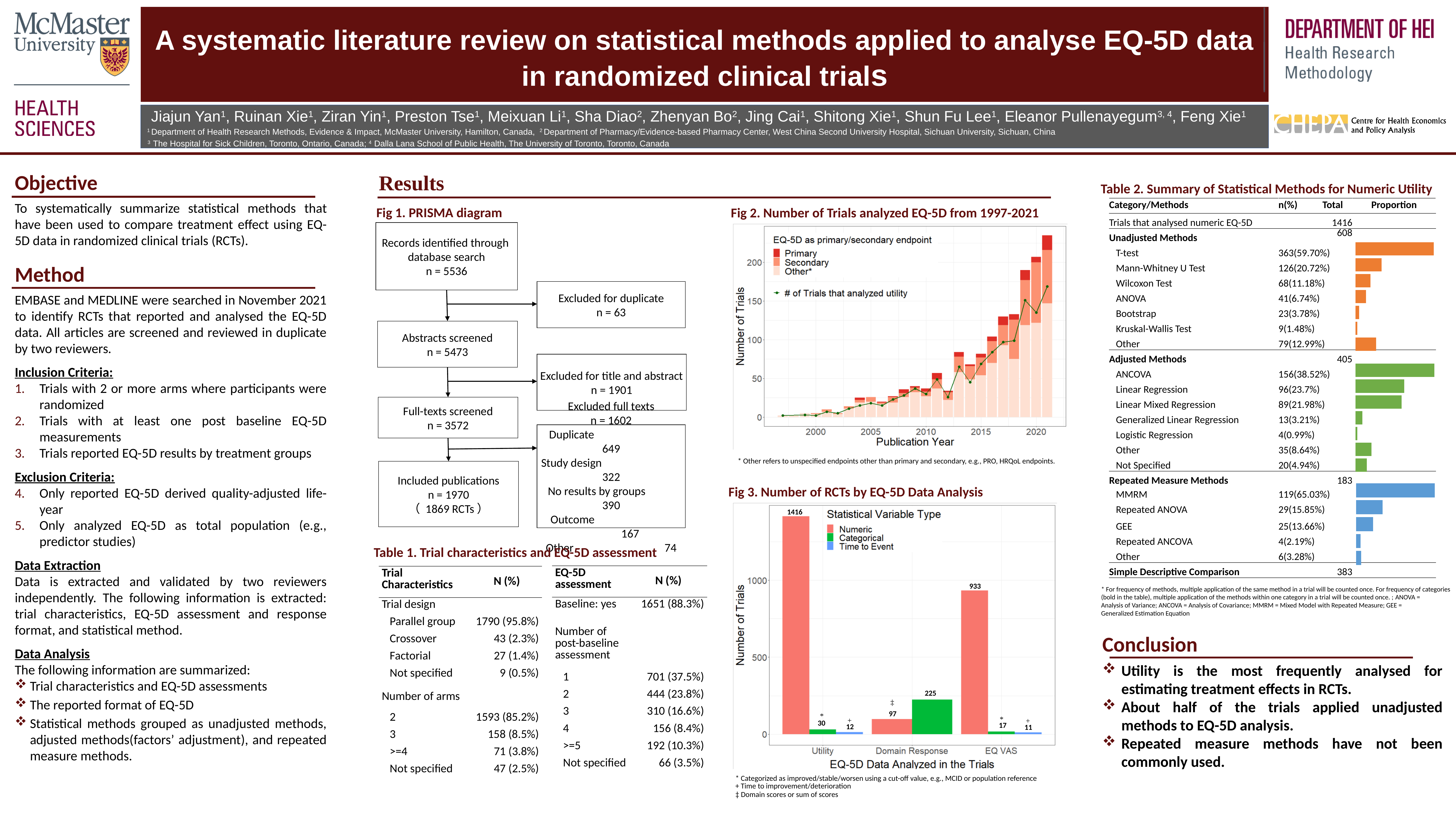
In Fig 3, what is the number of trials for Categorical analysis of Domain Response? 225 In Fig 2, is the total number of trials for 2015 greater or less than 100? less In Fig 3, what is the number of trials for Numeric analysis of Utility? 1416 In Fig 3, what is the number of trials for Numeric analysis of EQ VAS? 933 In Fig 3, what is the number of trials for Time to Event analysis of Utility? 12 In Fig 3, which EQ-5D data type has the highest number of trials for Numeric analysis? Utility In Fig 3, what is the difference between the Numeric trials for Utility and the Numeric trials for EQ VAS? 483 What kind of chart is Fig 3? Bar chart In Fig 3, which is larger for Domain Response: the Numeric bar or the Categorical bar? Categorical In Fig 2, does the number of trials generally rise or fall from 1997 to 2021? Rise In Fig 2, is the total number of trials for 2021 greater or less than 200? greater In Fig 3, how many statistical variable types does the legend list? 3